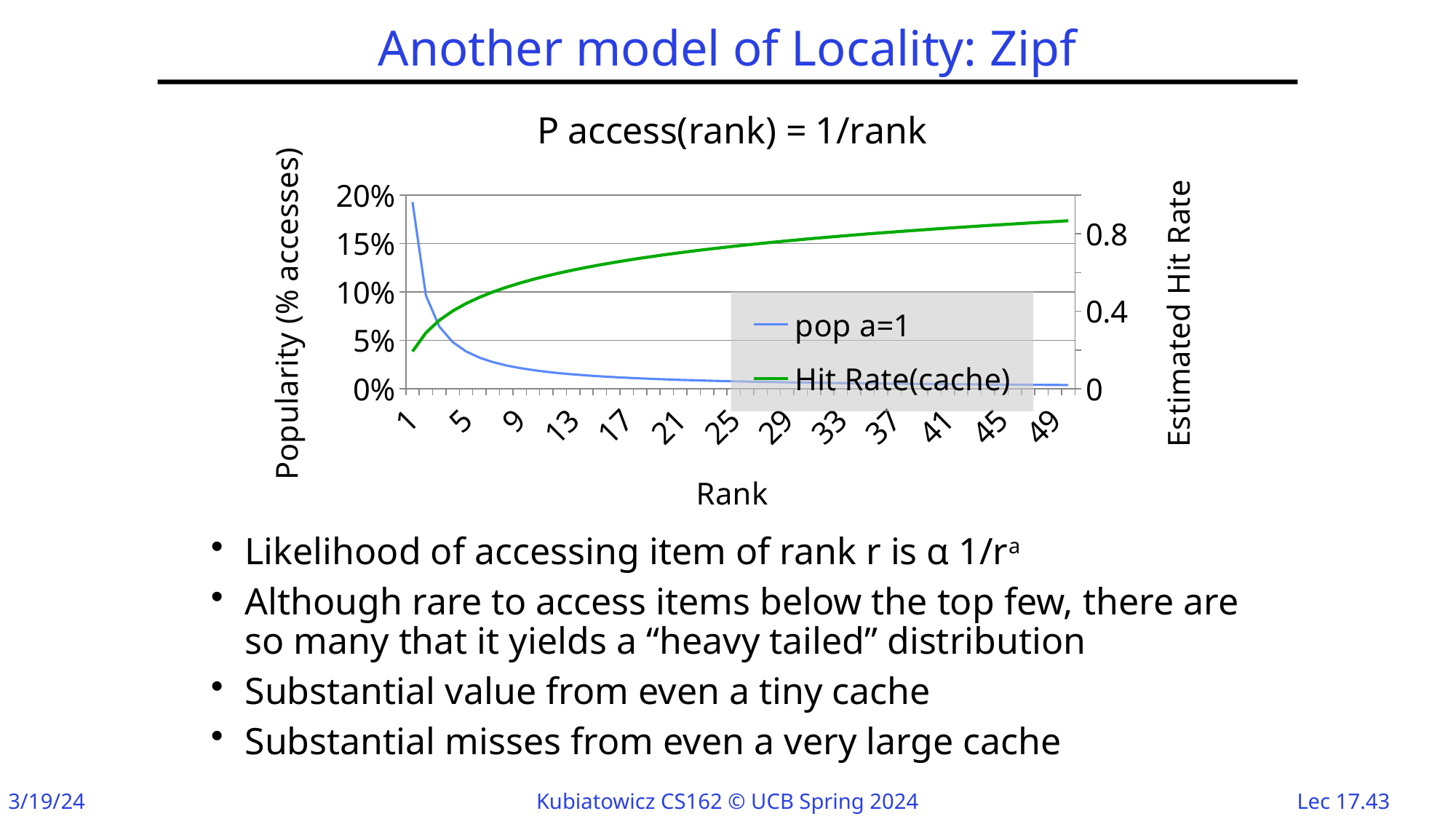
What is the label of the chart's x axis? Rank Is the value of 'pop a=1' at rank 9 greater or less than 5%? less At which rank is the 'Hit Rate(cache)' series lowest? 1 Is the value of 'Hit Rate(cache)' at rank 49 greater or less than 0.8? greater Is the value of 'Hit Rate(cache)' at rank 1 greater or less than 0.4? less What is the title of the chart? P access(rank) = 1/rank Does the 'Hit Rate(cache)' series rise or fall as rank increases along the x axis? rise How many series does the chart's legend list? 2 What kind of chart is shown on the slide? line chart Does the 'pop a=1' series rise or fall as rank increases along the x axis? fall At which rank is the 'pop a=1' series highest? 1